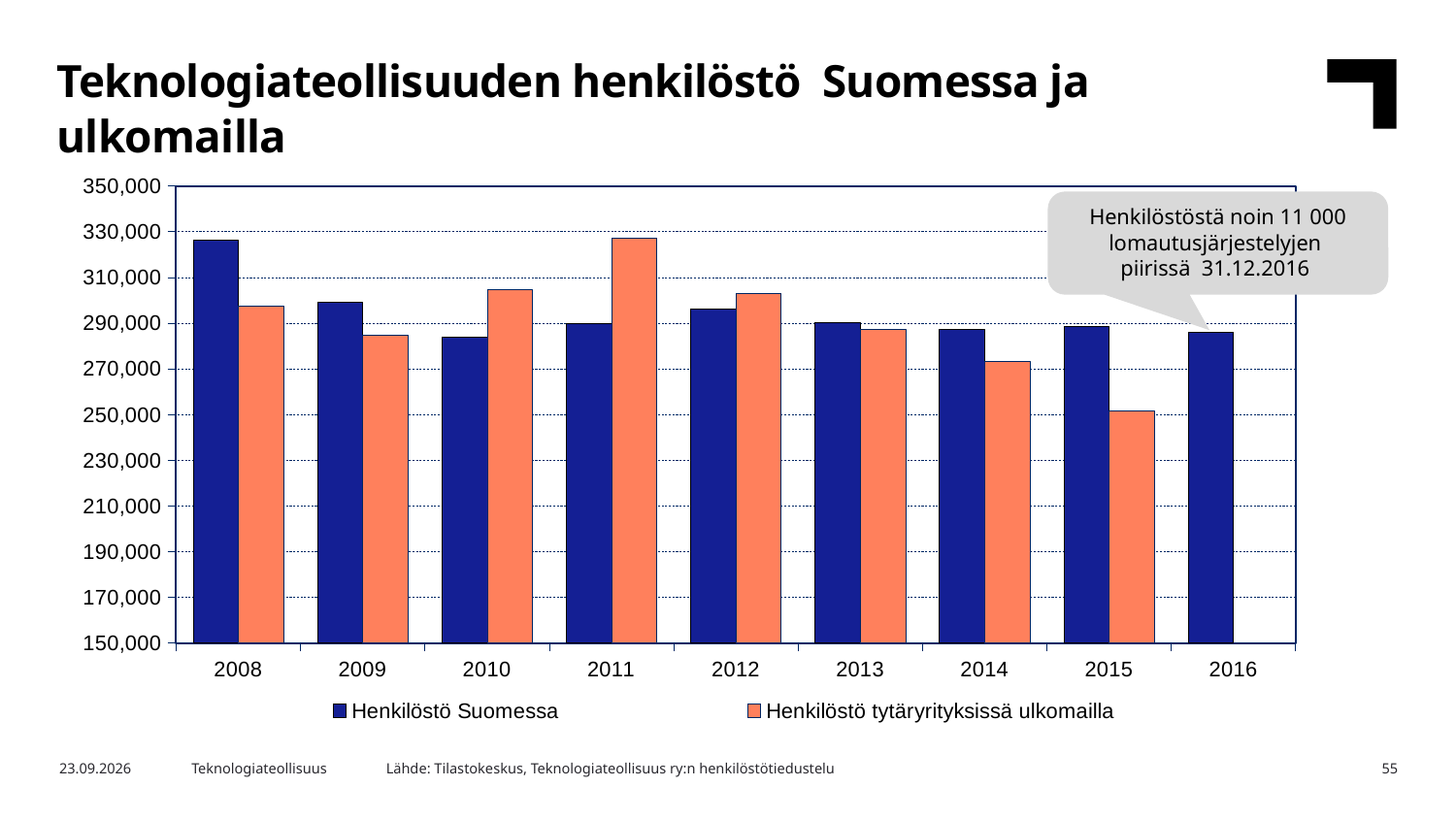
Does the value for Henkilöstö Suomessa rise or fall from 2008 to 2016? fall How many years are shown on the x axis? 9 How many series does the legend list? 2 Is the value for Henkilöstö Suomessa in 2008 greater or less than 310,000? greater Which year has a bar for only one of the two series? 2016 In which year is the value for Henkilöstö Suomessa highest? 2008 In which year is the value for Henkilöstö tytäryrityksissä ulkomailla lowest? 2015 In 2011, which is larger: Henkilöstö Suomessa or Henkilöstö tytäryrityksissä ulkomailla? Henkilöstö tytäryrityksissä ulkomailla What kind of chart is shown on the slide? bar chart In which year is the value for Henkilöstö tytäryrityksissä ulkomailla highest? 2011 Is the value for Henkilöstö tytäryrityksissä ulkomailla in 2015 greater or less than 270,000? less In 2015, which is larger: Henkilöstö Suomessa or Henkilöstö tytäryrityksissä ulkomailla? Henkilöstö Suomessa